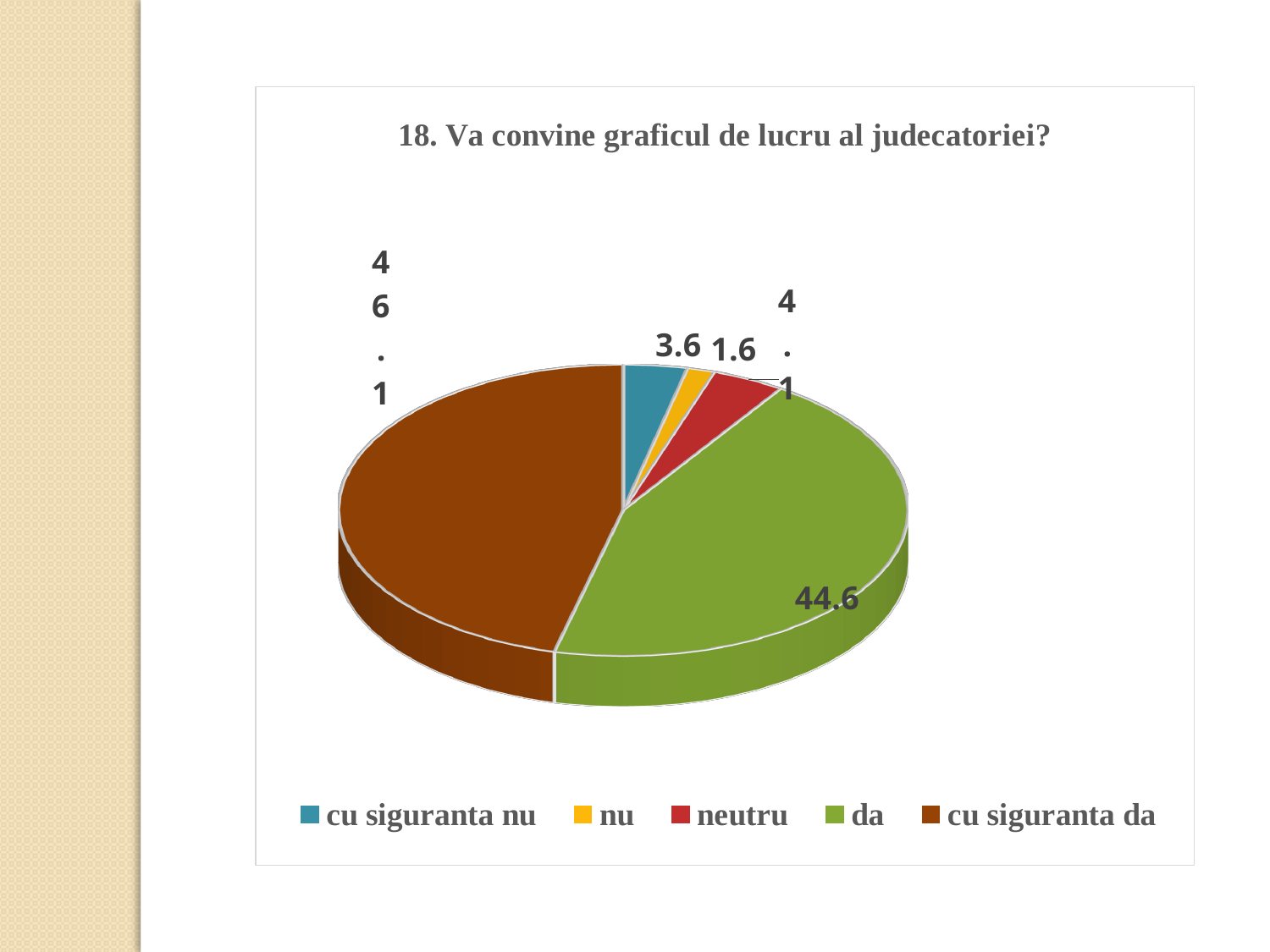
What is the value for 'neutru'? 4.1 What is the difference between the values for 'da' and 'cu siguranta nu'? 41 What is the value for 'da'? 44.6 What is the title of the chart? 18. Va convine graficul de lucru al judecatoriei? What is the value for 'nu'? 1.6 Which colour represents 'neutru' in the chart? red Which category has the smallest slice? nu What kind of chart is shown on the slide? pie chart How many categories does the legend list? 5 What is the value for 'cu siguranta nu'? 3.6 Which is larger, 'cu siguranta nu' or 'neutru'? neutru What is the value for 'cu siguranta da'? 46.1